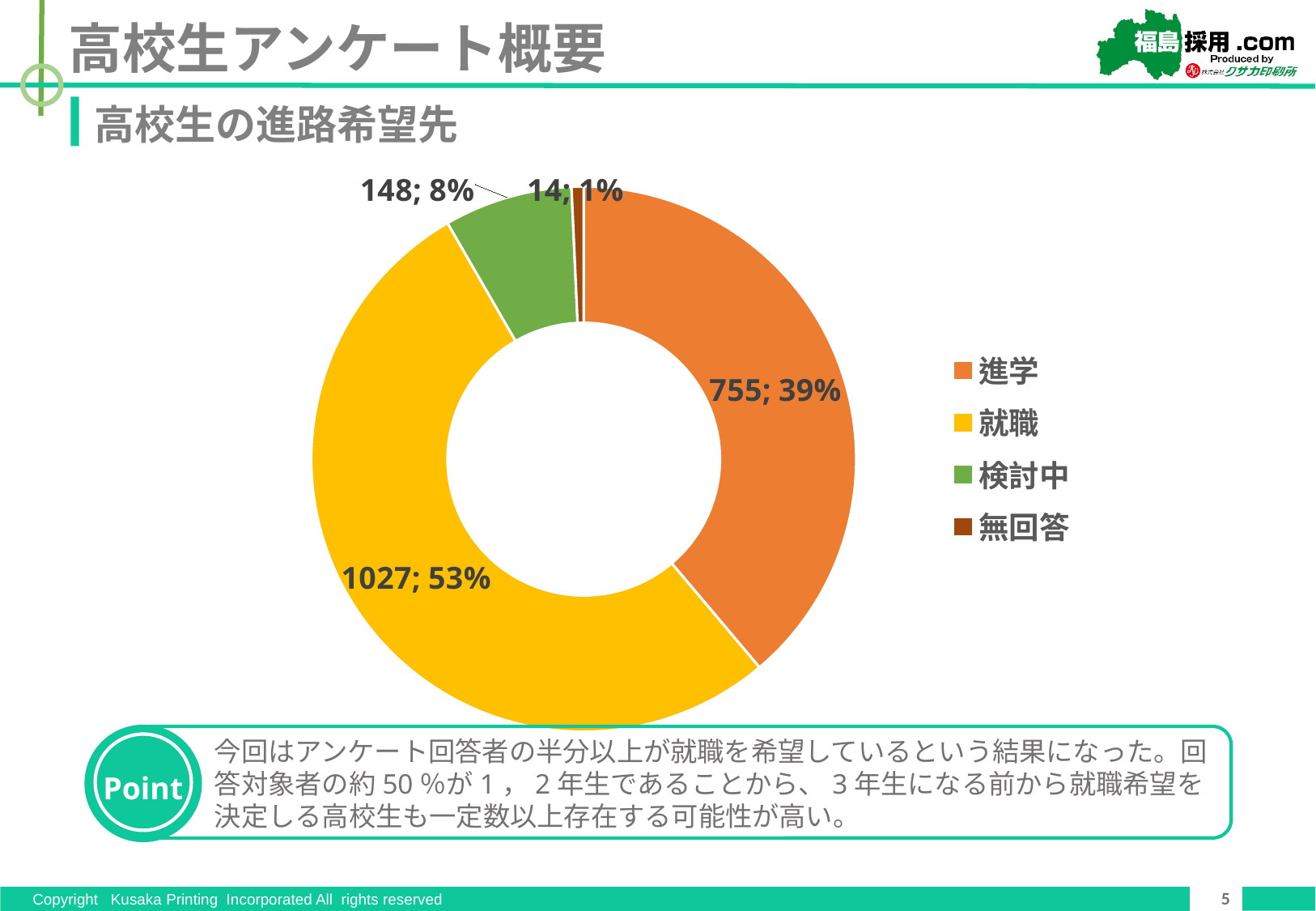
Which category has the largest slice? 就職 What is the value for 進学? 755 What is the value for 無回答? 14 What kind of chart is shown on the slide? Doughnut chart What is the difference between the values for 就職 and 進学? 272 How many categories does the chart show? 4 Which category has the smallest slice? 無回答 What is the value for 検討中? 148 What share of the chart does 就職 represent? 53% What share of the chart does 検討中 represent? 8% Which is larger, the value for 進学 or the value for 検討中? 進学 What is the value for 就職? 1027